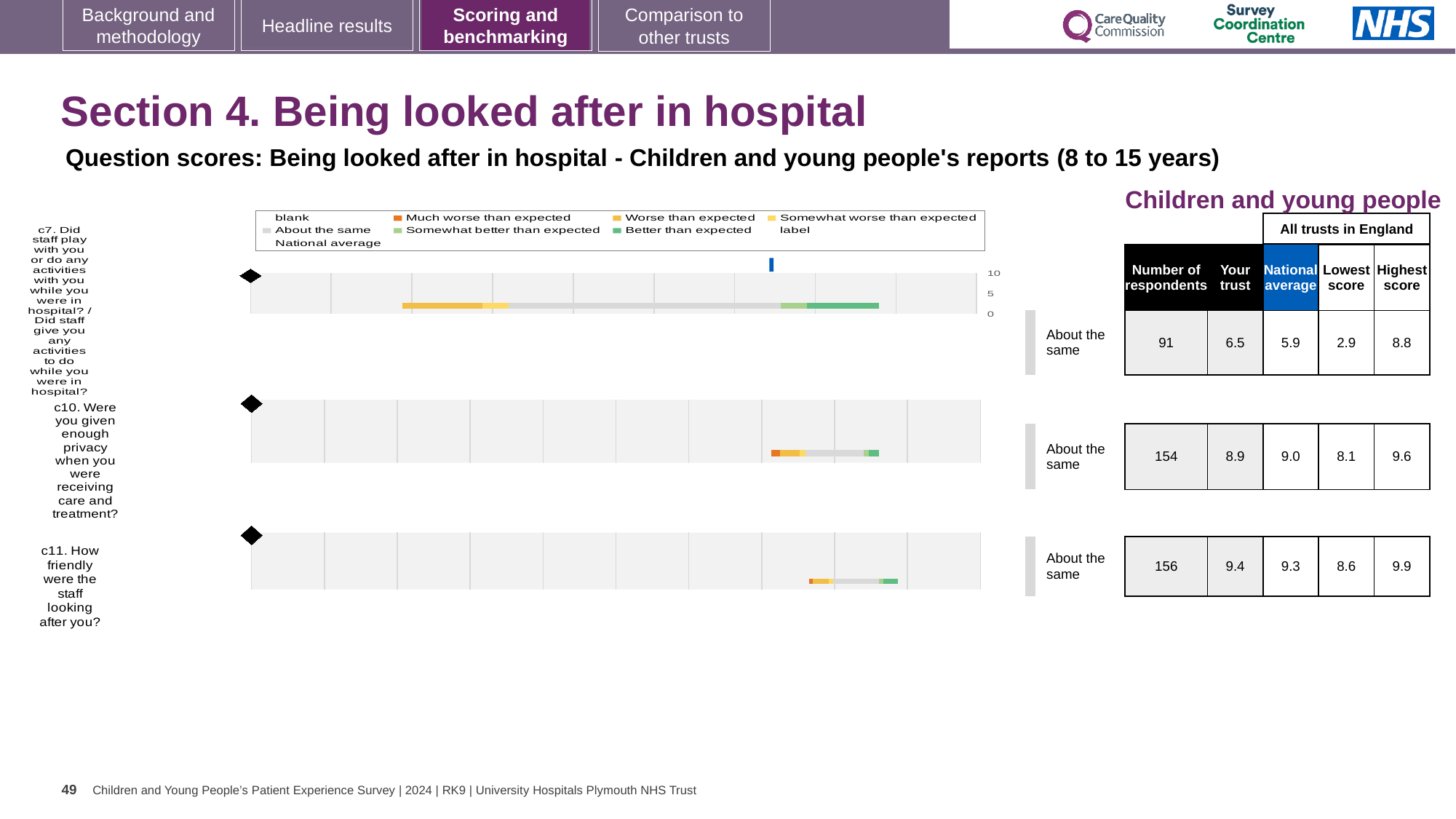
What is the national average score for c11 (How friendly were the staff looking after you?)? 9.3 For c7, what is the difference between the trust score and the national average? 0.6 How many questions (chart rows) are shown on the slide? 3 Which question has the highest 'Your trust' score? c11. How friendly were the staff looking after you? What benchmark category is shown for c7? About the same What is the highest score across all trusts in England for c11? 9.9 How many respondents answered c7 (Did staff play with you or do any activities with you while you were in hospital?)? 91 What is the lowest score across all trusts in England for c10? 8.1 What is the 'Your trust' score for c10 (Were you given enough privacy when you were receiving care and treatment?)? 8.9 What kind of chart is used to show the question scores on this slide? bar chart For c10, which is larger: the trust score or the national average? National average Which question has the lowest 'Your trust' score? c7. Did staff play with you or do any activities with you while you were in hospital?